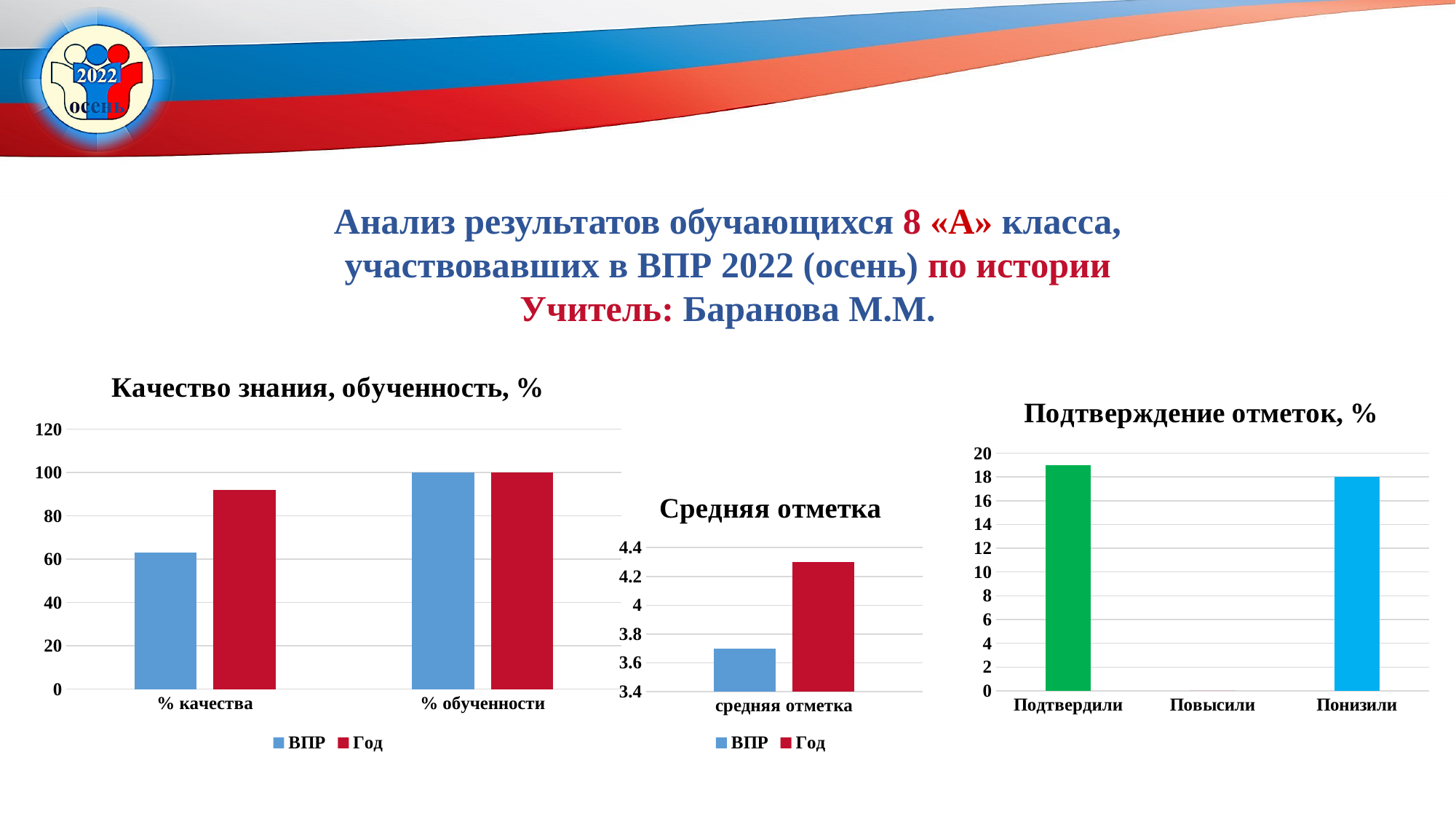
What kind of chart is 'Средняя отметка'? bar chart In the chart 'Качество знания, обученность, %', is the value of ВПР for % качества greater or less than 80? less How many series does the legend of the chart 'Качество знания, обученность, %' list? 2 In the chart 'Подтверждение отметок, %', what is the value for Повысили? 0 In the chart 'Качество знания, обученность, %', what is the value of ВПР for % обученности? 100 In the chart 'Качество знания, обученность, %', which series has the larger value for % качества, ВПР or Год? Год In the chart 'Подтверждение отметок, %', which category has the lowest value? Повысили In the chart 'Подтверждение отметок, %', what is the value for Понизили? 18 In the chart 'Средняя отметка', which series has the larger value, ВПР or Год? Год In the chart 'Средняя отметка', is the value of ВПР greater or less than 4? less In the chart 'Качество знания, обученность, %', is the value of Год for % качества greater or less than 80? greater How many categories are shown in the chart 'Подтверждение отметок, %'? 3